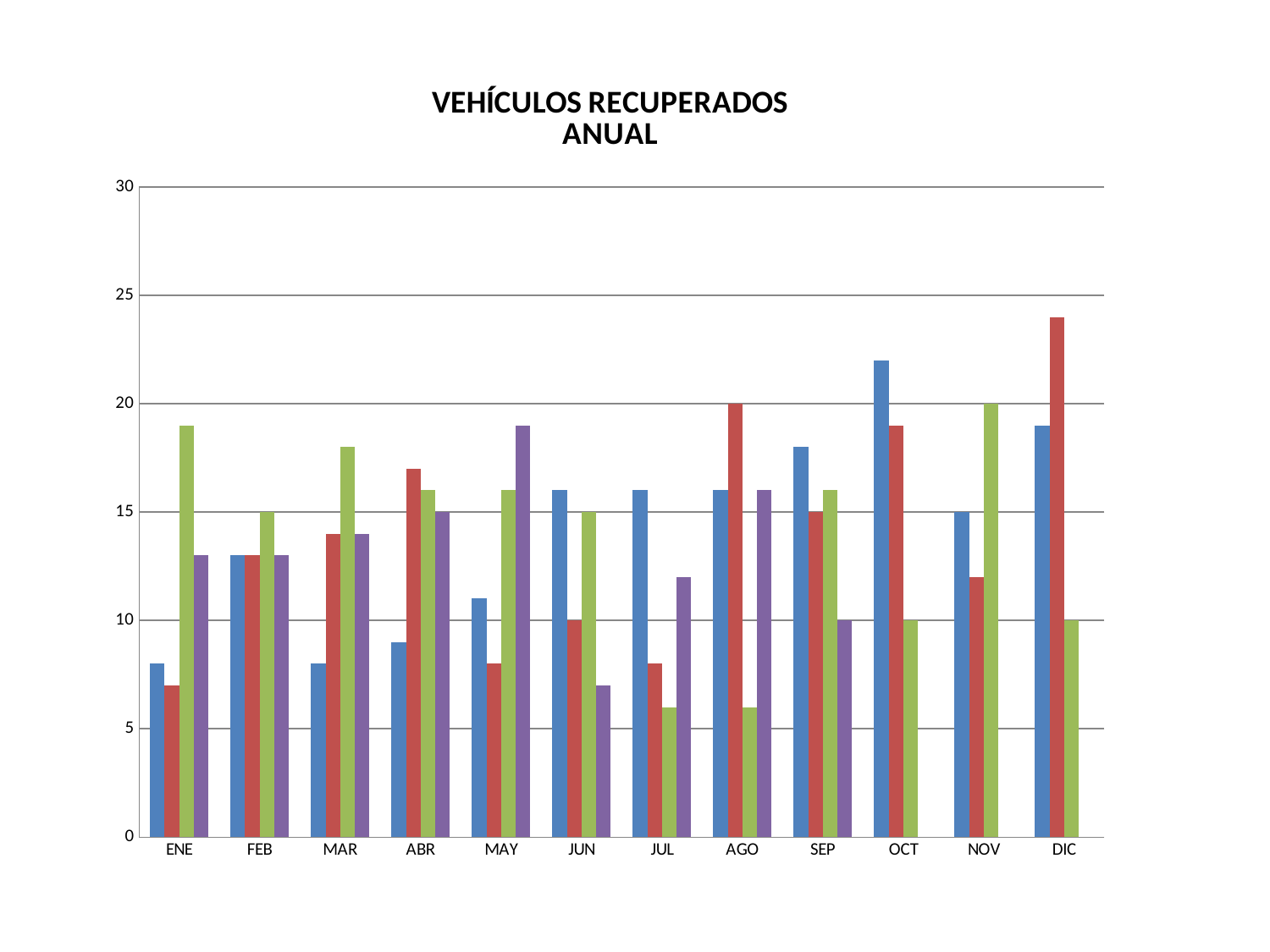
Is the green bar for ENE greater or less than 15? greater In which month is the red bar the tallest? DIC Is the blue bar for OCT greater or less than 20? greater What is the title of the chart? VEHÍCULOS RECUPERADOS ANUAL Is the green bar for JUL greater or less than 10? less In which month is the blue bar the tallest? OCT How many months (categories) are shown on the x axis? 12 What kind of chart is shown on the slide? bar chart In DIC, which bar is taller, the red bar or the green bar? red In ENE, which bar is taller, the green bar or the blue bar? green